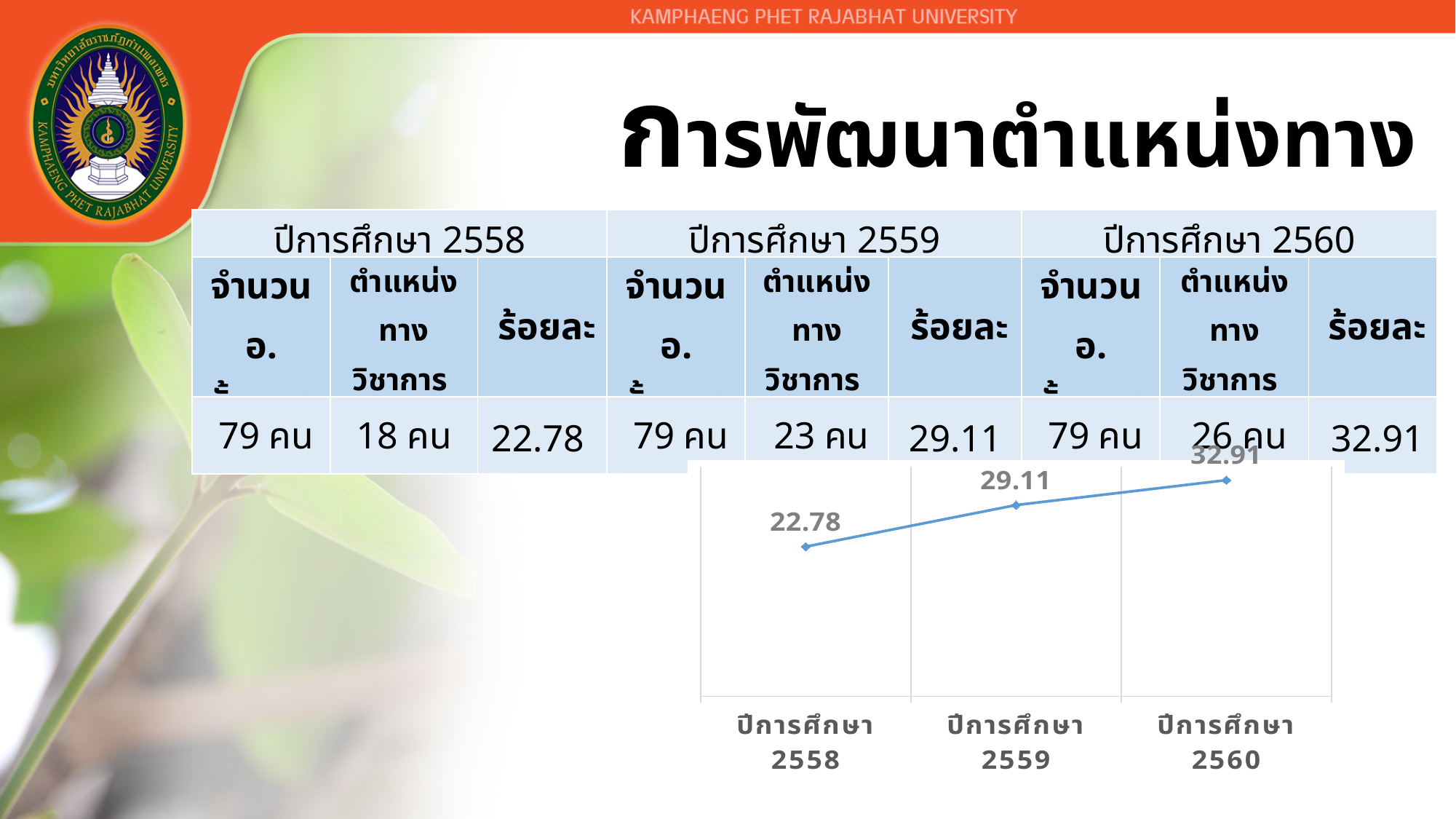
What is the value plotted for ปีการศึกษา 2560? 32.91 Do the values rise or fall from ปีการศึกษา 2558 to ปีการศึกษา 2560? rise What is the difference between the values for ปีการศึกษา 2560 and ปีการศึกษา 2558? 10.13 What is the value plotted for ปีการศึกษา 2559? 29.11 What is the difference between the values for ปีการศึกษา 2559 and ปีการศึกษา 2558? 6.33 Which is larger, the value for ปีการศึกษา 2559 or ปีการศึกษา 2560? ปีการศึกษา 2560 How many data points are plotted on the line chart? 3 What type of chart is shown on the slide? line chart What is the value plotted for ปีการศึกษา 2558? 22.78 Which academic year has the highest value on the chart? ปีการศึกษา 2560 Which academic year has the lowest value on the chart? ปีการศึกษา 2558 What colour is the line in the chart? blue